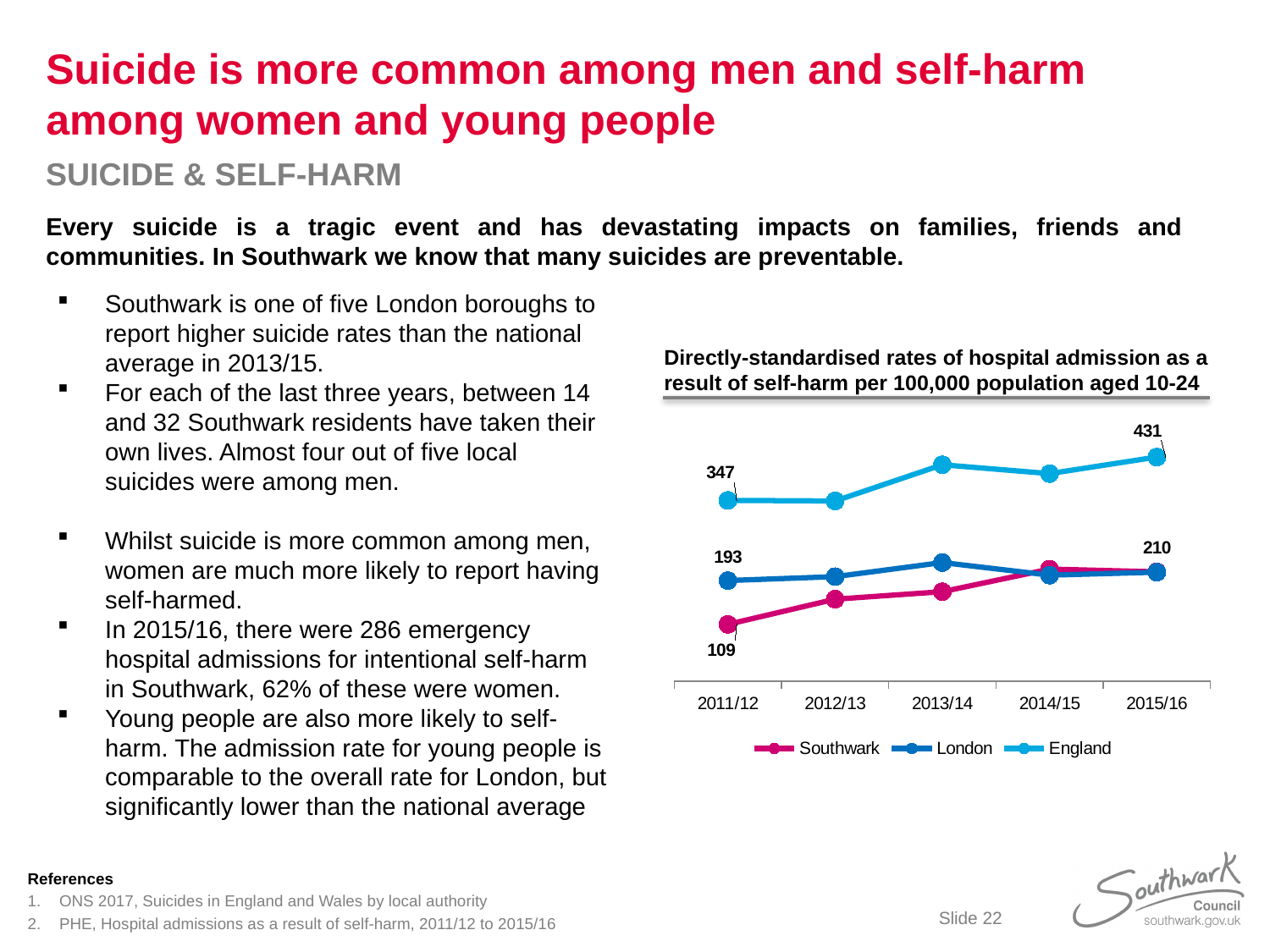
What is the rate for England in 2011/12? 347 What is the rate for England in 2015/16? 431 How many years are shown along the x axis? 5 How many series does the legend list? 3 What is the difference between the London and Southwark rates in 2011/12? 84 Which series has the highest rate in 2011/12? England What kind of chart is shown on the slide? line chart What is the rate for London in 2011/12? 193 Which series has the lowest rate in 2011/12? Southwark What is the rate for Southwark in 2011/12? 109 By how much did the England rate increase from 2011/12 to 2015/16? 84 Does the Southwark rate rise or fall from 2011/12 to 2015/16? rise